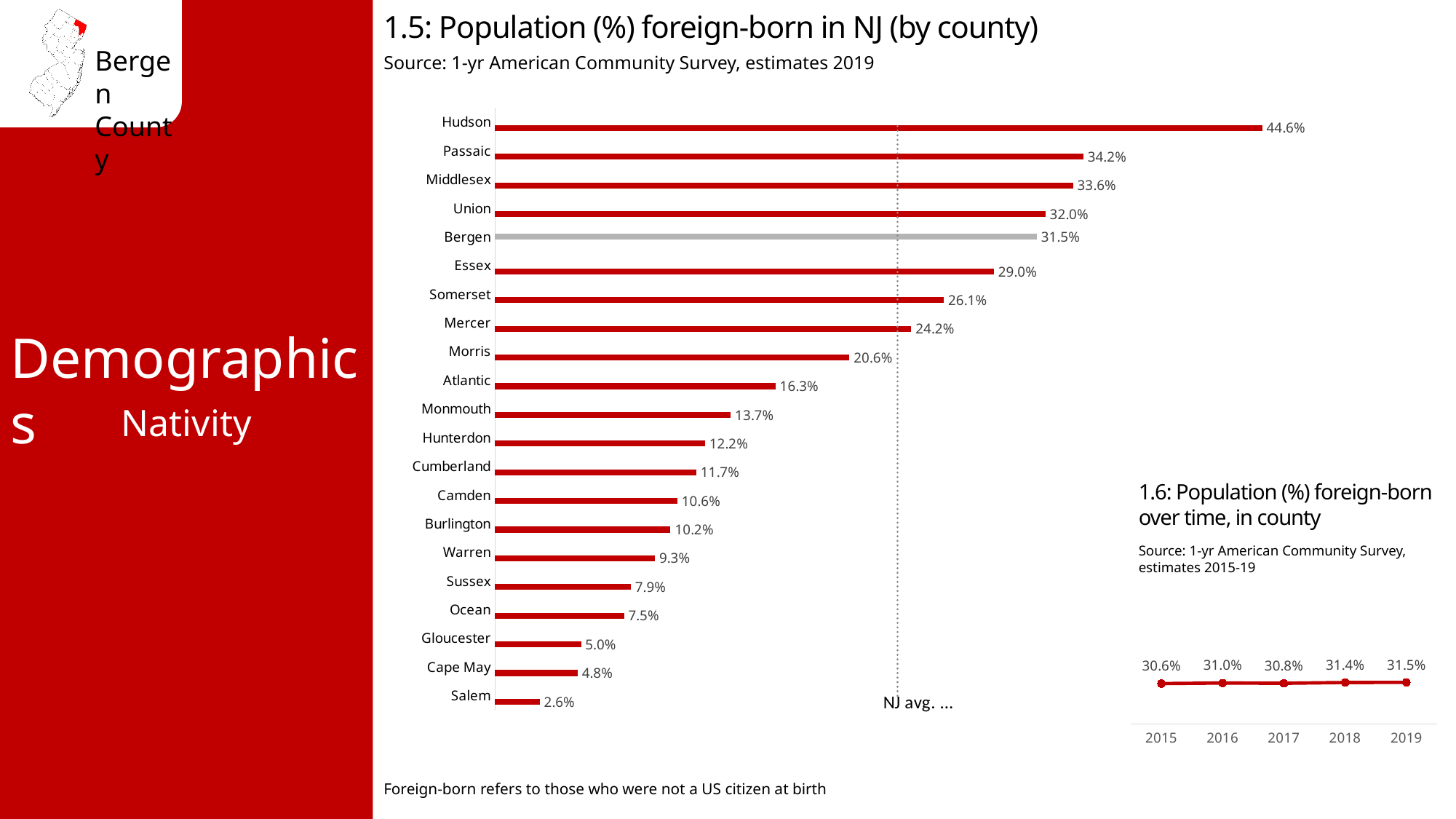
In chart 1.5 (Population (%) foreign-born in NJ by county), what is the value for Bergen? 31.5% In chart 1.5 (Population (%) foreign-born in NJ by county), which county has the highest value? Hudson In chart 1.6 (Population (%) foreign-born over time, in county), what is the difference between 2019 and 2015? 0.9% In chart 1.5 (Population (%) foreign-born in NJ by county), what is the difference between Hudson and Passaic? 10.4% What kind of chart is chart 1.6 (Population (%) foreign-born over time, in county)? Line chart In chart 1.5 (Population (%) foreign-born in NJ by county), how many counties are plotted? 21 What kind of chart is chart 1.5 (Population (%) foreign-born in NJ by county)? Bar chart In chart 1.5 (Population (%) foreign-born in NJ by county), what is the value for Mercer? 24.2% In chart 1.6 (Population (%) foreign-born over time, in county), what is the value for 2017? 30.8% In chart 1.6 (Population (%) foreign-born over time, in county), which year has the highest value? 2019 In chart 1.5 (Population (%) foreign-born in NJ by county), which county has the lowest value? Salem In chart 1.5 (Population (%) foreign-born in NJ by county), which is larger, Essex or Somerset? Essex